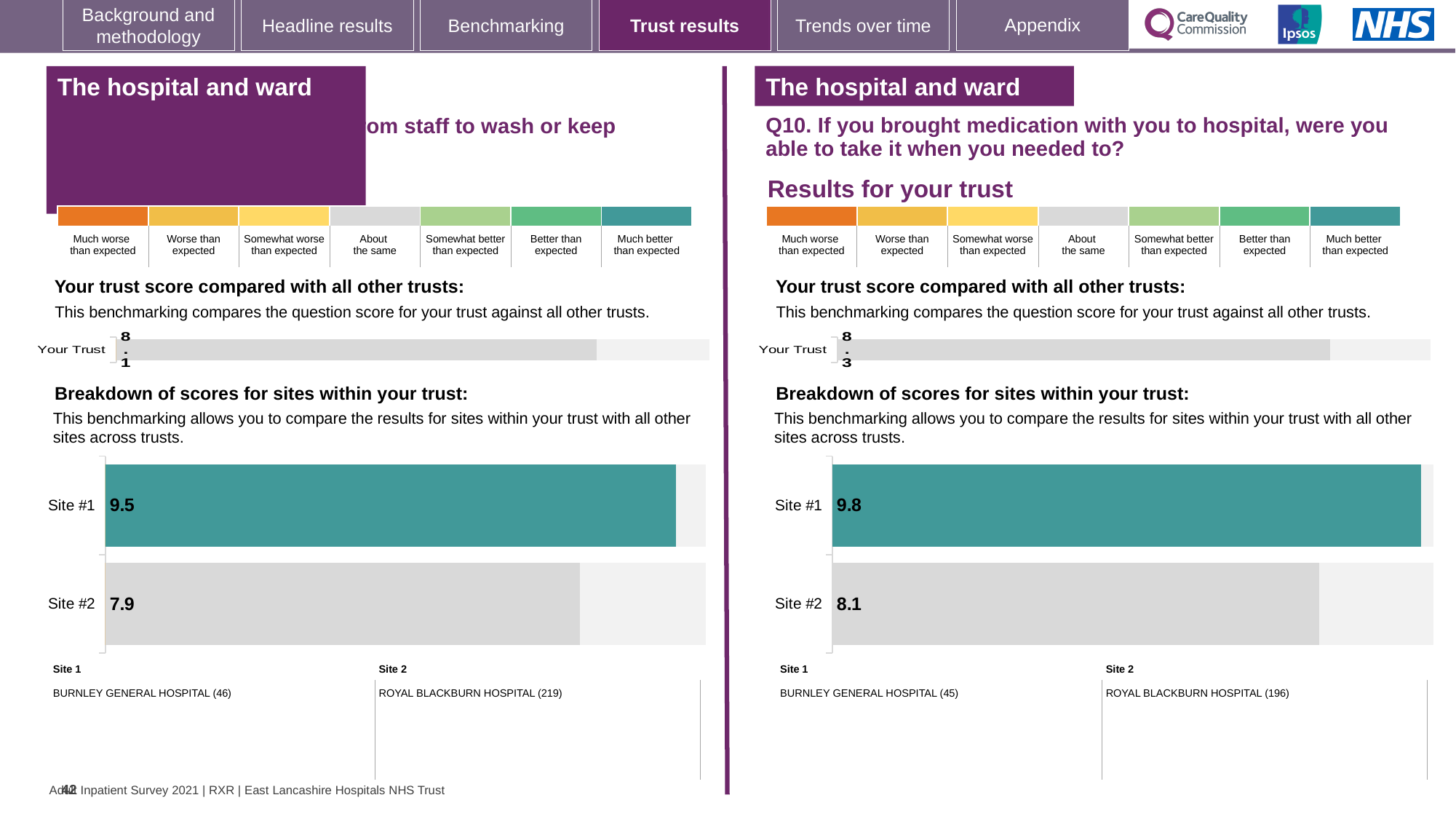
On the left-hand chart, what is the 'Your Trust' score? 8.1 On the right-hand chart (Q10, medication), what is the score for Site #1? 9.8 What type of chart is used for the site breakdown on the left-hand side of the slide? Bar chart On the right-hand chart (Q10, medication), what is the difference between the Site #1 and Site #2 scores? 1.7 On the left-hand chart, which site has the lower score? Site #2 On the right-hand chart (Q10, medication), which site has the higher score? Site #1 On the left-hand chart, what is the score for Site #2? 7.9 How many sites are shown in the site breakdown chart on the right-hand side (Q10, medication)? 2 On the left-hand chart, what is the difference between the Site #1 and Site #2 scores? 1.6 On the right-hand chart (Q10, medication), what is the score for Site #2? 8.1 On the left-hand chart, what is the score for Site #1? 9.5 On the right-hand chart (Q10, medication), what is the 'Your Trust' score? 8.3